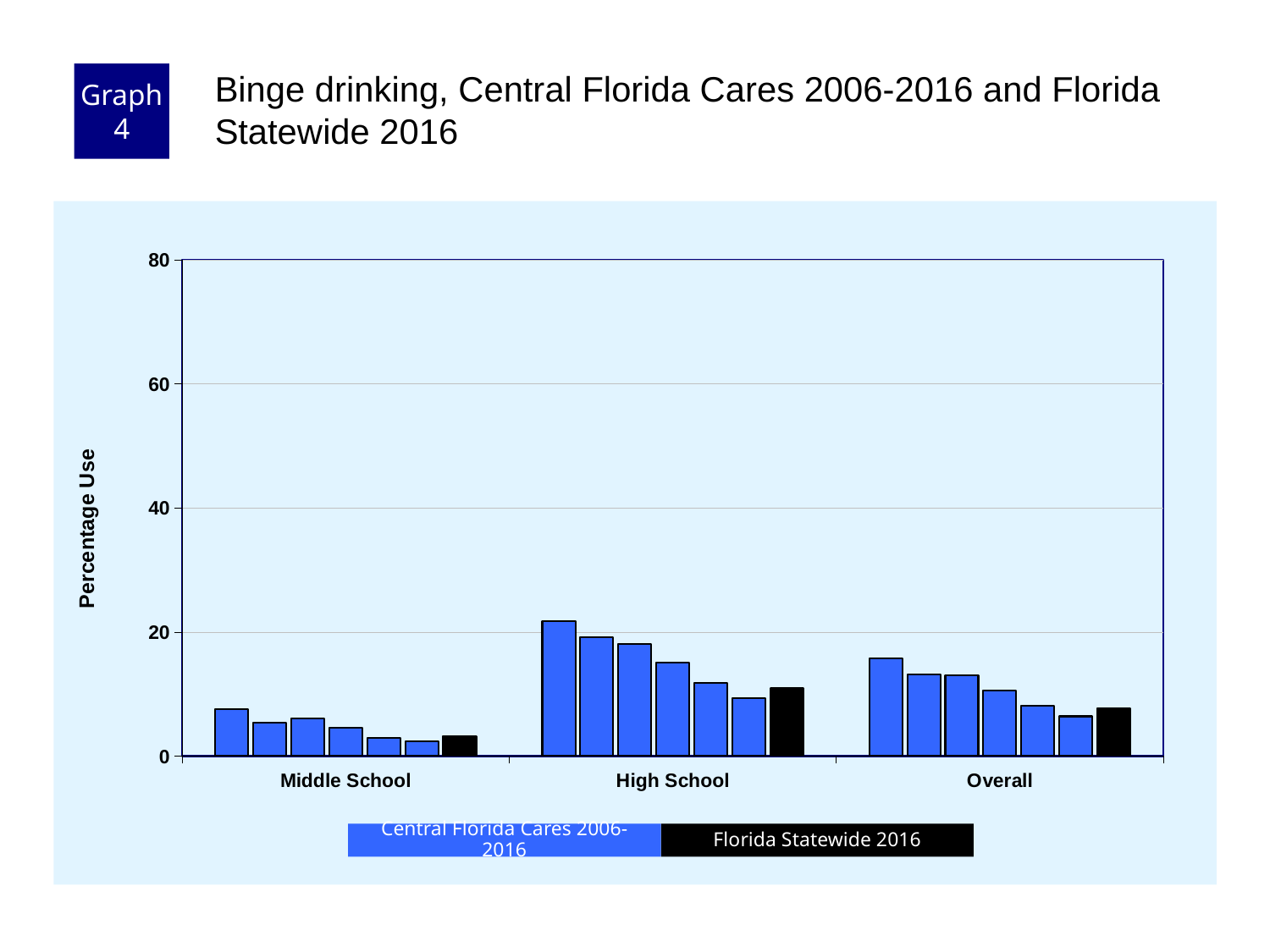
How many categories are shown along the x axis? 3 Are all the High School bars greater or less than 40? less Which category has the lowest bars? Middle School What is the label on the y axis? Percentage Use How many series does the legend list? 2 What type of chart is shown on the slide? bar chart Which category has the highest bars? High School Is the Florida Statewide 2016 value for High School greater or less than 20? less Is the Florida Statewide 2016 value for Middle School greater or less than 20? less Which is larger, the Florida Statewide 2016 bar for High School or the Florida Statewide 2016 bar for Middle School? High School Within the High School group, do the Central Florida Cares 2006-2016 bars rise or fall from left to right? fall